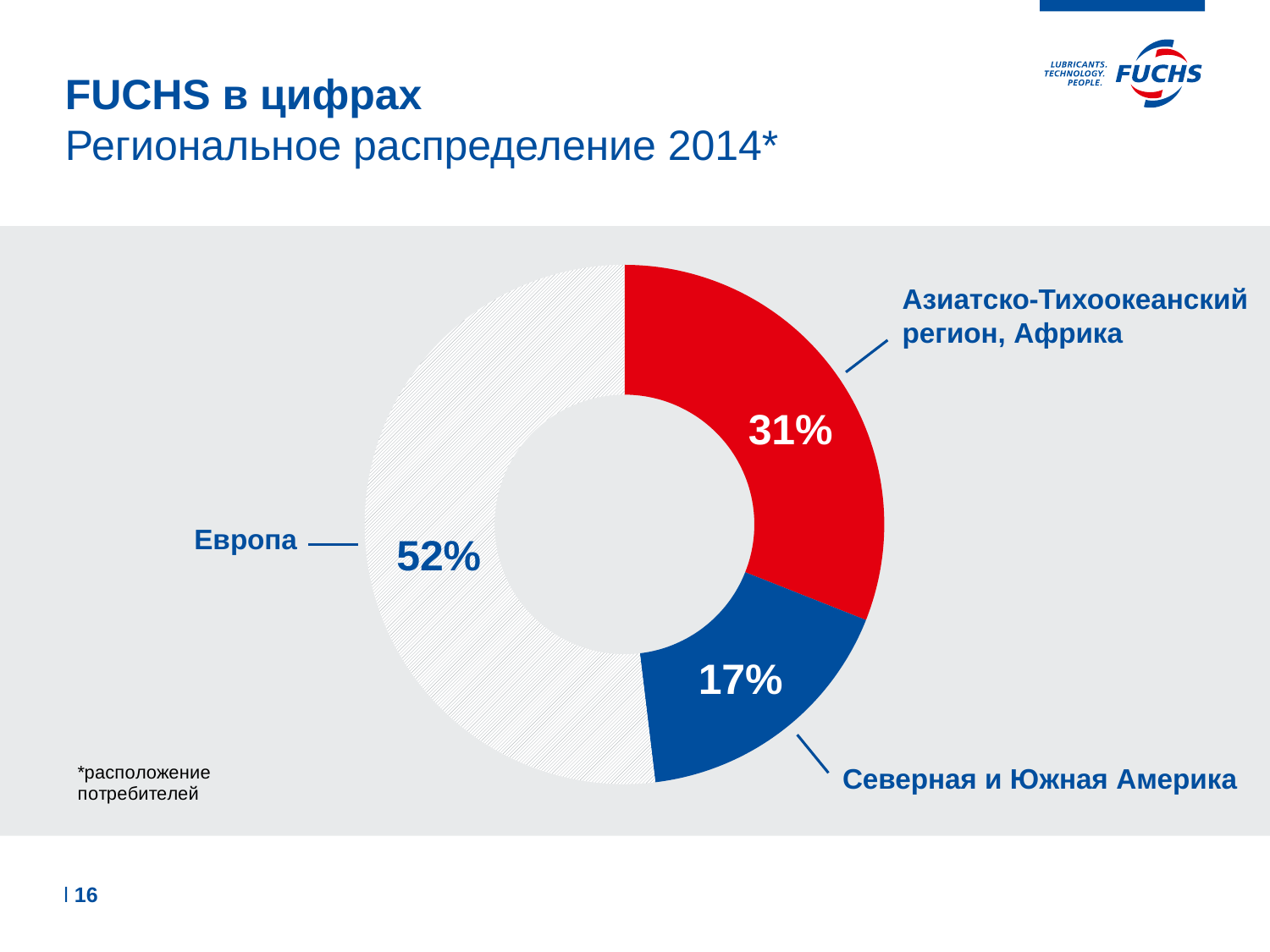
What is the difference in percentage points between the share for Азиатско-Тихоокеанский регион, Африка and the share for Северная и Южная Америка? 14 What share is shown for Северная и Южная Америка (North and South America)? 17% What kind of chart is shown on the slide? Pie chart (doughnut) Which region has the largest share in the chart? Европа What share of the regional distribution does Европа (Europe) account for? 52% How many regions are shown in the chart? 3 Which has a larger share: Азиатско-Тихоокеанский регион, Африка or Северная и Южная Америка? Азиатско-Тихоокеанский регион, Африка What colour is the slice for Азиатско-Тихоокеанский регион, Африка? Red What is the difference in percentage points between the share for Европа and the share for Азиатско-Тихоокеанский регион, Африка? 21 What is the subtitle of the chart on the slide? Региональное распределение 2014* What share is shown for Азиатско-Тихоокеанский регион, Африка (Asia-Pacific, Africa)? 31% Which region has the smallest share in the chart? Северная и Южная Америка